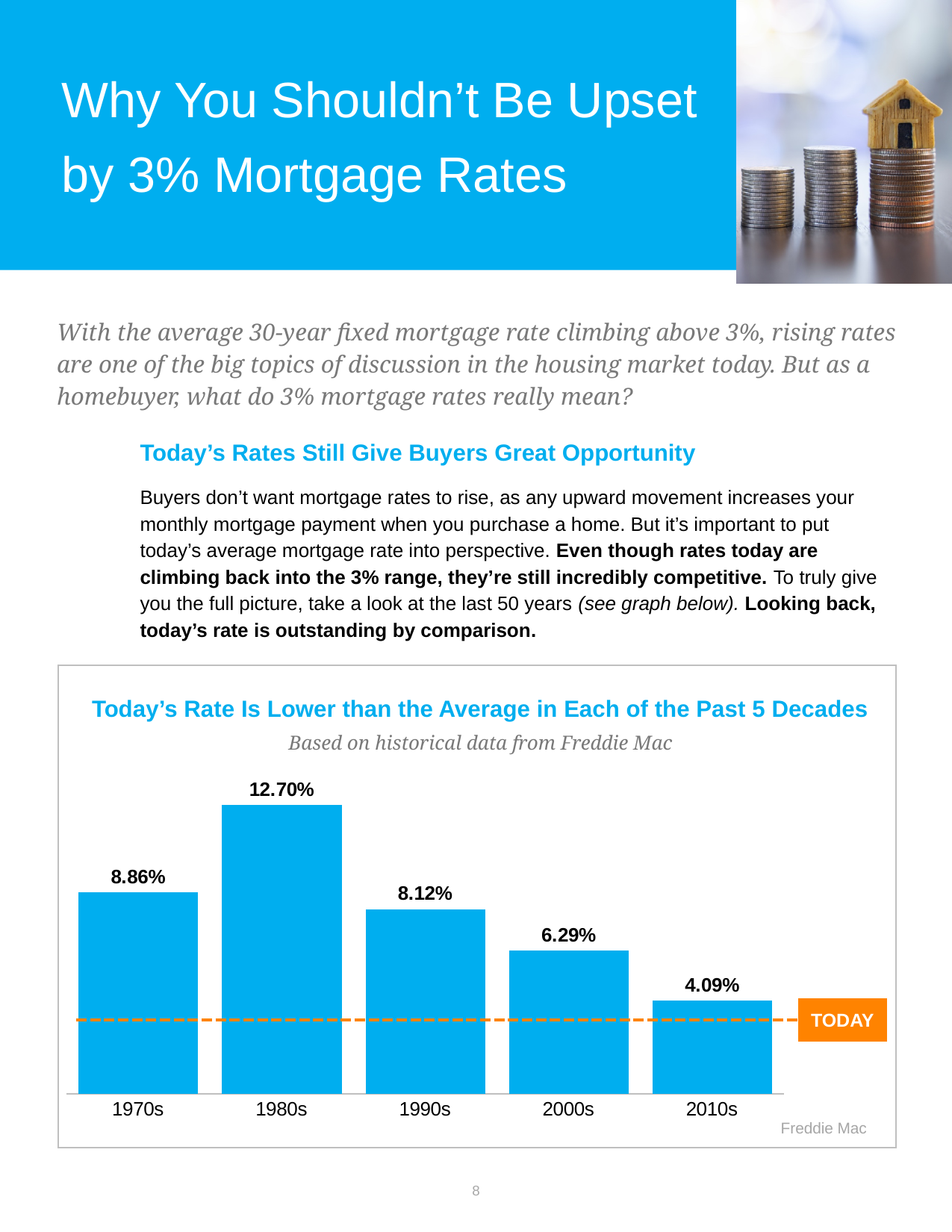
Which decade has the lowest average mortgage rate? 2010s What kind of chart is shown on the slide? Bar chart What is the average mortgage rate shown for the 2010s? 4.09% From the 1980s to the 2010s, do the rates rise or fall? Fall What is the title of the chart? Today's Rate Is Lower than the Average in Each of the Past 5 Decades How many decades are shown as bars in the chart? 5 What is the difference between the 1990s rate and the 2000s rate? 1.83% What is the average mortgage rate shown for the 1980s? 12.70% Which is larger, the rate for the 1970s or the rate for the 1990s? 1970s What is the difference between the 1980s rate and the 2010s rate? 8.61% Which decade has the highest average mortgage rate? 1980s What is the average mortgage rate shown for the 1970s? 8.86%